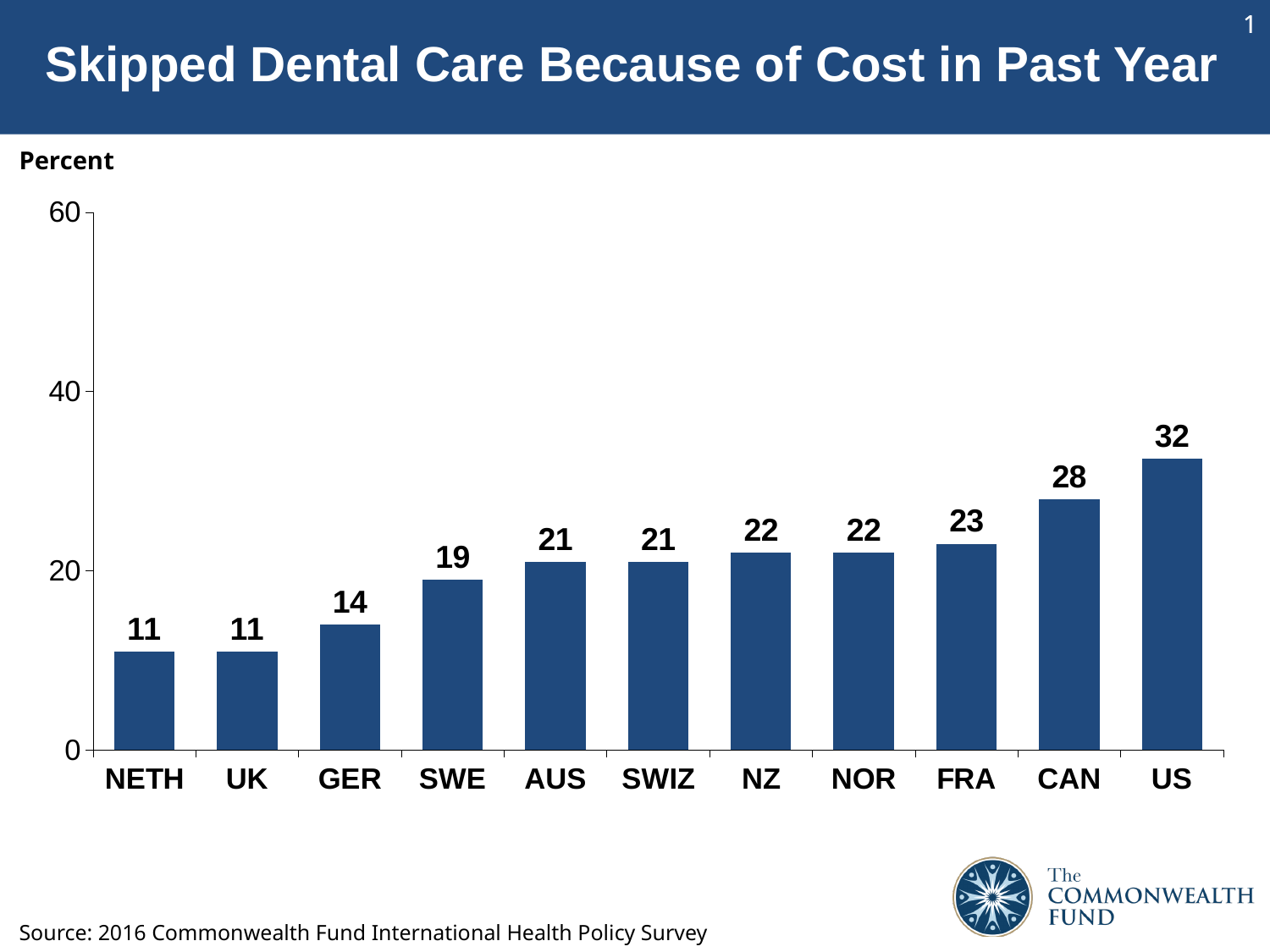
What is the value for SWE? 19 What is the title of the chart? Skipped Dental Care Because of Cost in Past Year What kind of chart is shown on the slide? bar chart How many countries are shown on the chart? 11 What is the value for GER? 14 Which is larger, the value for CAN or the value for SWE? CAN What is the value for the US? 32 Which country has the highest value? US Is the value for the US greater or less than 40? less What is the difference between the values for the US and NETH? 21 Do the values generally rise or fall from left to right across the countries? rise What is the difference between the values for CAN and FRA? 5